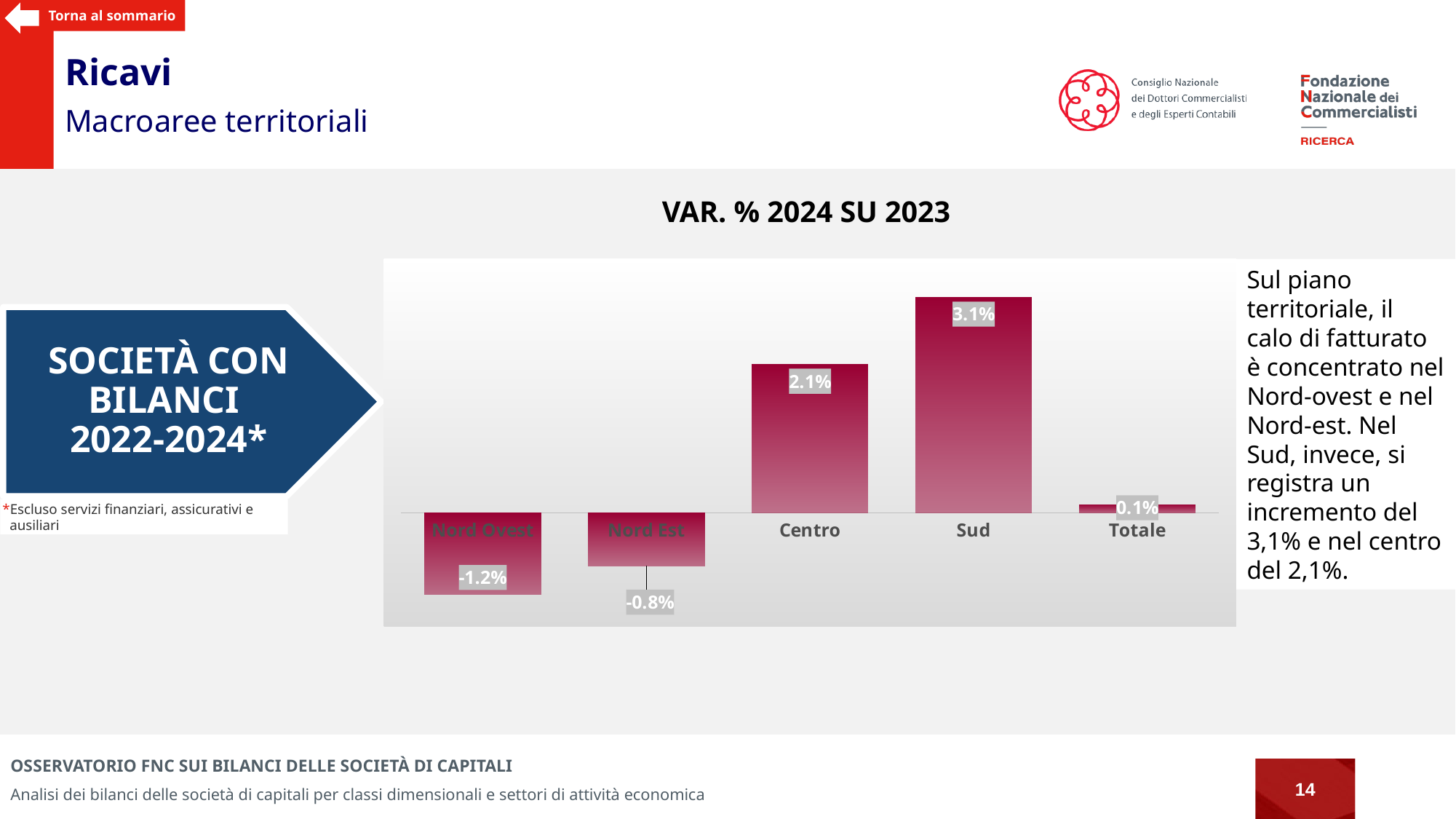
Which category has the highest value? Sud What is the difference between the values for Sud and Centro? 1.0% What kind of chart is shown on the slide? Bar chart What is the value for Sud? 3.1% What is the value for Nord Est? -0.8% What is the value for Centro? 2.1% Which category has the lowest value? Nord Ovest What is the title of the chart? VAR. % 2024 SU 2023 How many categories are shown in the chart? 5 What is the value for Totale? 0.1% Which is larger, the value for Centro or the value for Totale? Centro What is the value for Nord Ovest? -1.2%